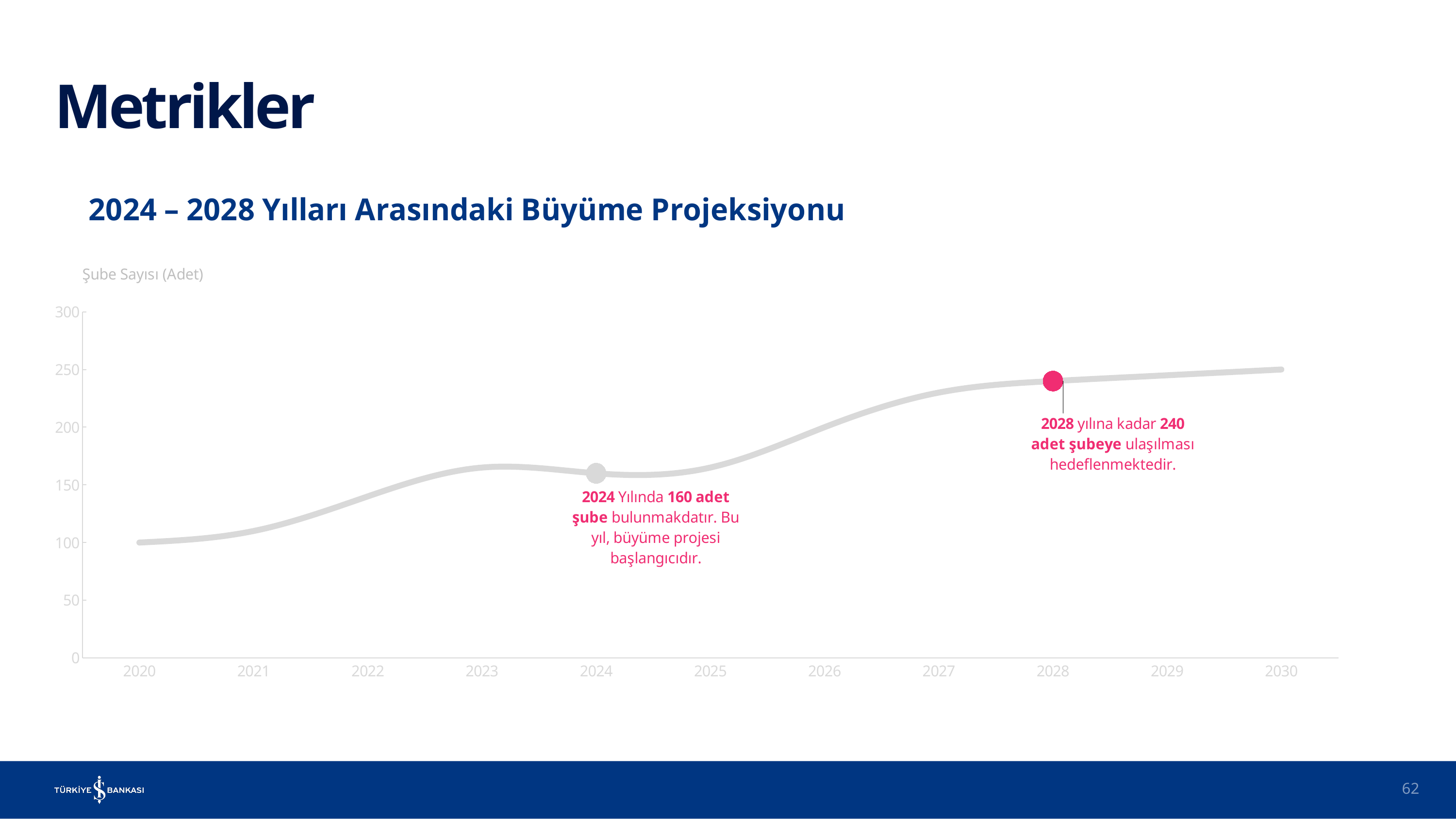
Is the value for 2022 greater or less than 150? less What is the title of the chart? 2024 – 2028 Yılları Arasındaki Büyüme Projeksiyonu What kind of chart is shown on the slide? line chart What is the number of branches (Şube Sayısı) in 2024? 160 What is the label of the y axis? Şube Sayısı (Adet) Do the values generally rise or fall from 2020 to 2030? rise Which year has the larger branch count, 2024 or 2028? 2028 Which year has the lowest branch count? 2020 What is the difference between the branch count for 2028 and the branch count for 2024? 80 What is the targeted number of branches for 2028? 240 How many years are shown on the x axis? 11